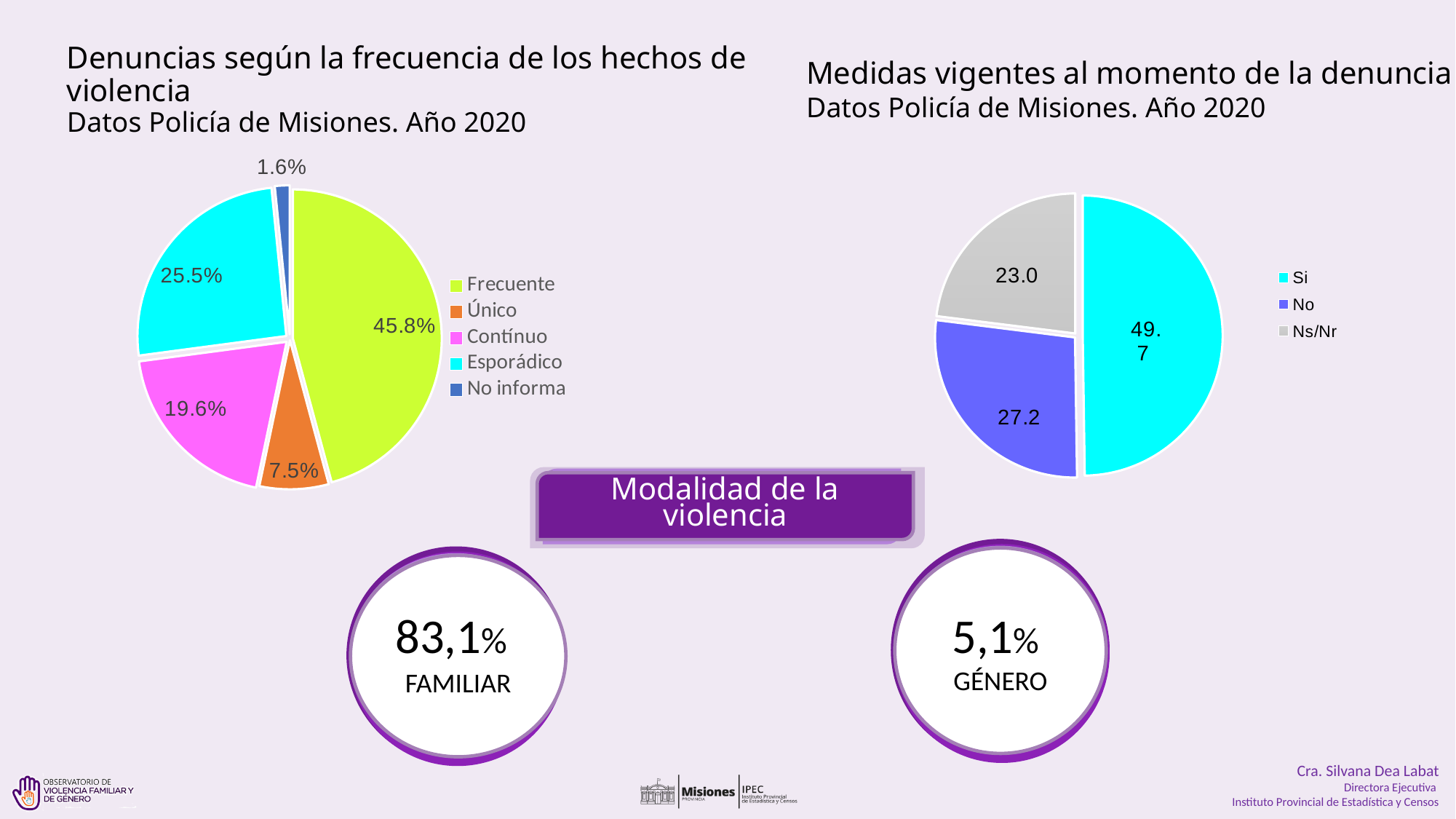
In the 'Medidas vigentes al momento de la denuncia' chart, what value is shown for Ns/Nr? 23.0 In the 'Denuncias según la frecuencia de los hechos de violencia' chart, what percentage is shown for Frecuente? 45.8% In the 'Medidas vigentes al momento de la denuncia' chart, what is the difference between the Si and No values? 22.5 In the 'Denuncias según la frecuencia de los hechos de violencia' chart, which category has the largest share? Frecuente In the 'Medidas vigentes al momento de la denuncia' chart, which category has the largest share? Si What type of chart is the 'Medidas vigentes al momento de la denuncia' chart? Pie chart In the 'Medidas vigentes al momento de la denuncia' chart, what value is shown for No? 27.2 In the 'Denuncias según la frecuencia de los hechos de violencia' chart, what percentage is shown for Esporádico? 25.5% In the 'Denuncias según la frecuencia de los hechos de violencia' chart, what is the difference between the Esporádico and Contínuo shares? 5.9% In the 'Denuncias según la frecuencia de los hechos de violencia' chart, which is larger: Único or Contínuo? Contínuo In the 'Denuncias según la frecuencia de los hechos de violencia' chart, which category has the smallest share? No informa In the 'Denuncias según la frecuencia de los hechos de violencia' chart, how many categories does the legend list? 5